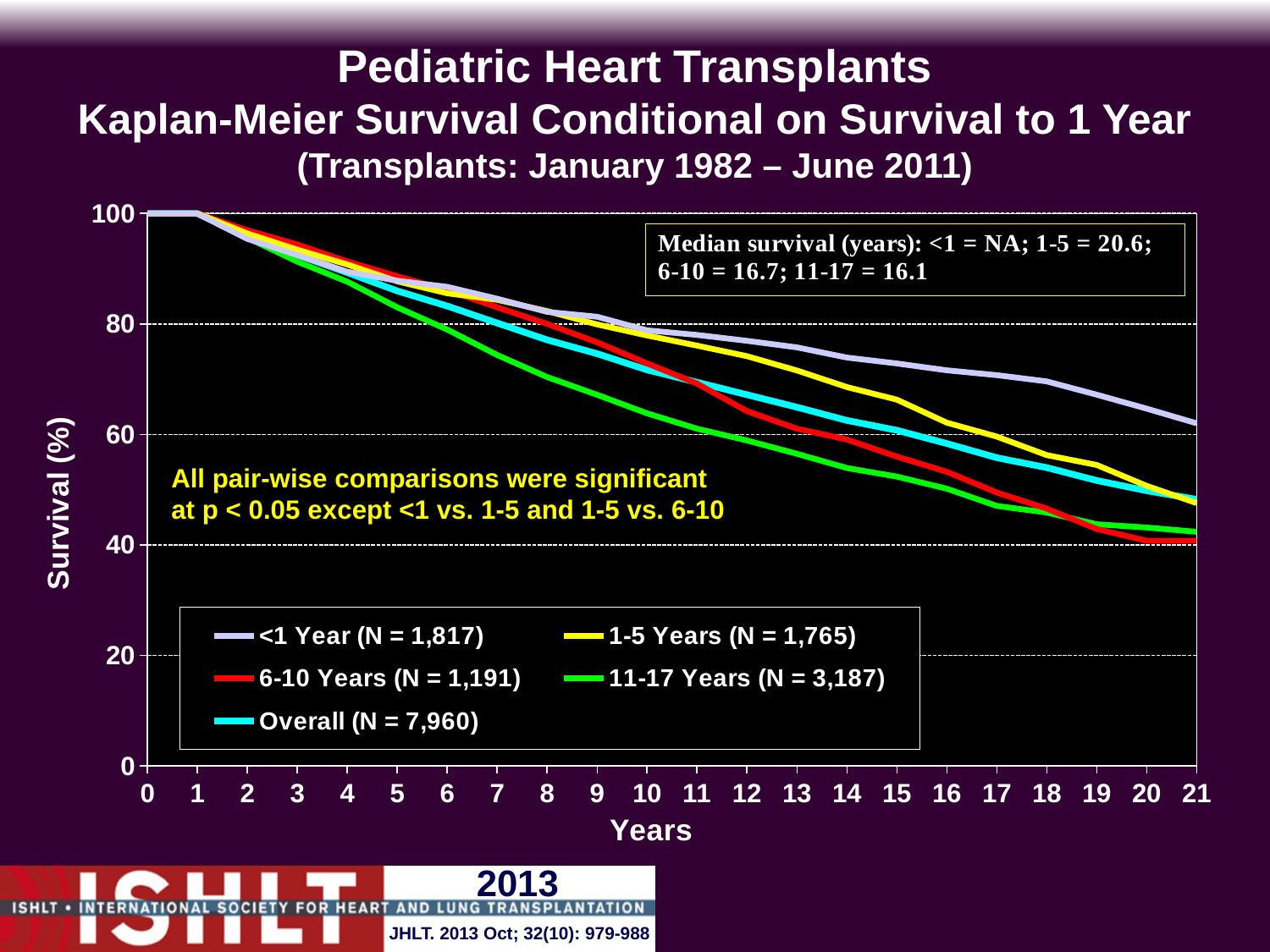
How many series does the legend list? 5 Which series has the highest survival at 21 years? <1 Year Is the survival for the <1 Year group at 21 years greater or less than 60? greater What is the median survival for the <1 Year group, as stated in the text box? NA Which series has the lowest survival at 10 years? 11-17 Years What is the median survival in years for the 11-17 Years group, as stated in the text box? 16.1 What is the median survival in years for the 1-5 Years group, as stated in the text box? 20.6 At 15 years, which is larger: survival for the <1 Year group or the 11-17 Years group? <1 Year Do the survival curves rise or fall as years increase? fall Is the survival for the 1-5 Years group at 21 years greater or less than 60? less What is the difference between the median survival of the 6-10 Years group and the 11-17 Years group, using the values in the text box? 0.6 What kind of chart is shown on the slide? line chart